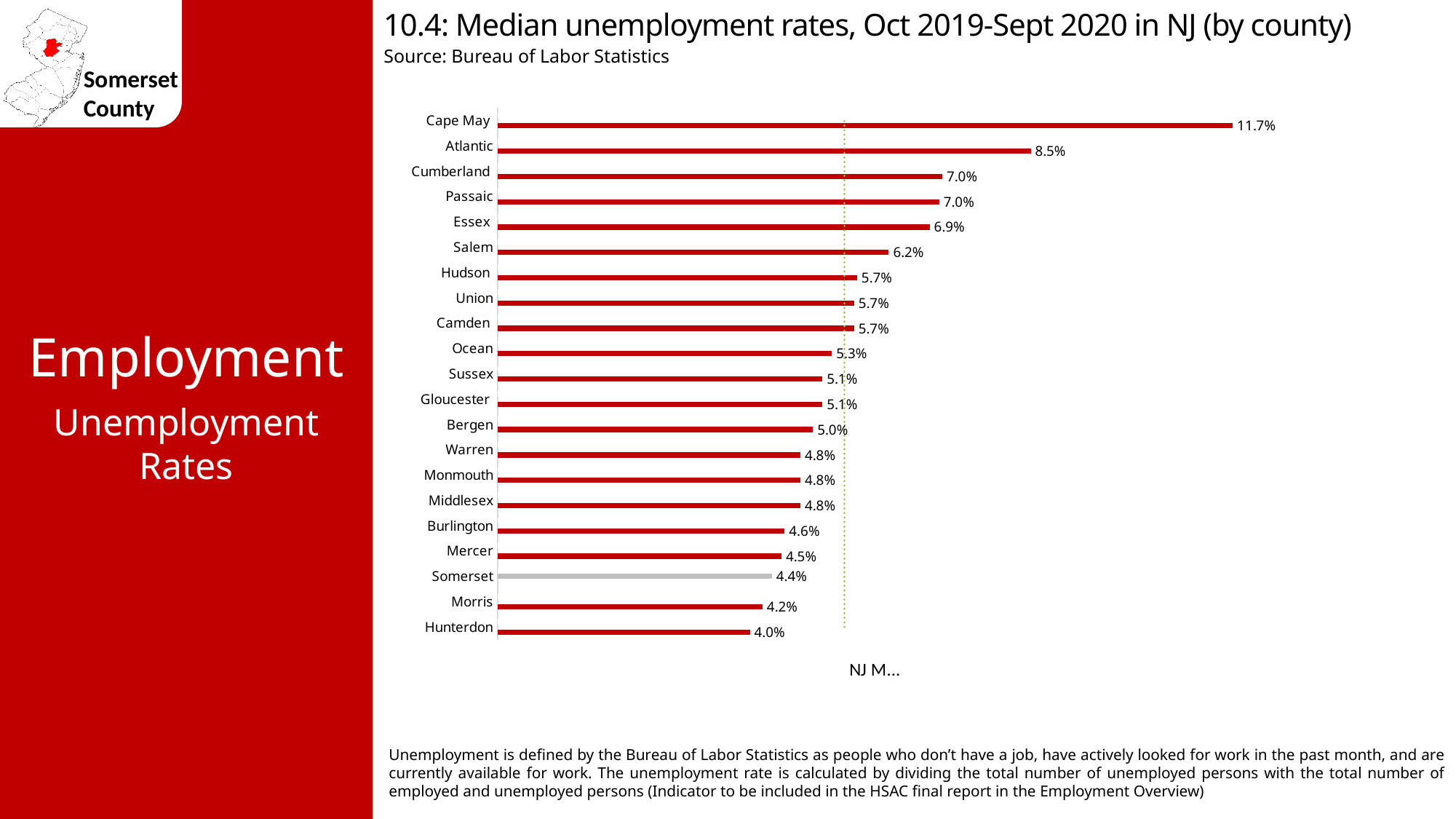
What is the median unemployment rate for Cape May? 11.7% How many counties are shown in the chart? 21 What is the difference between the median unemployment rates of Cape May and Atlantic? 3.2% What is the median unemployment rate for Bergen? 5.0% Which has a higher median unemployment rate, Salem or Ocean? Salem Which county has the lowest median unemployment rate? Hunterdon What is the difference between the median unemployment rates of Somerset and Hunterdon? 0.4% Which county has the highest median unemployment rate? Cape May Which county's bar is shown in grey instead of red? Somerset What type of chart is used to show the median unemployment rates? Bar chart Which has a higher median unemployment rate, Mercer or Morris? Mercer What is the median unemployment rate for Somerset? 4.4%